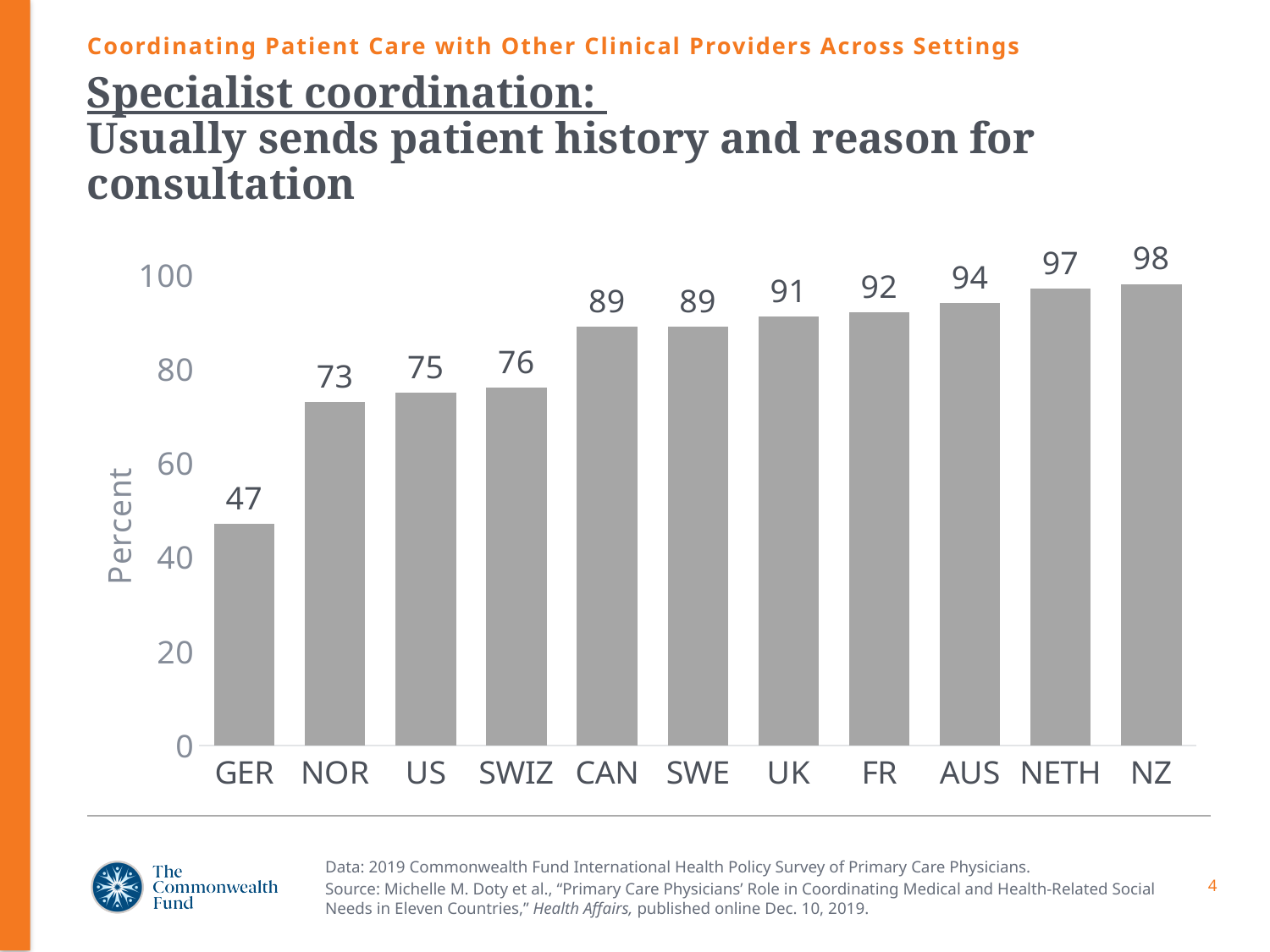
How many countries are shown on the chart? 11 What is the value for SWIZ? 76 Which country has the lowest value? GER What kind of chart is shown on the slide? Bar chart What is the difference between the values for US and NOR? 2 Which country has the highest value? NZ What is the value for AUS? 94 Which is larger, the value for UK or the value for CAN? UK Is the value for NOR greater or less than 60? greater What is the value for GER? 47 What is the difference between the values for NZ and GER? 51 What is the label on the vertical axis? Percent